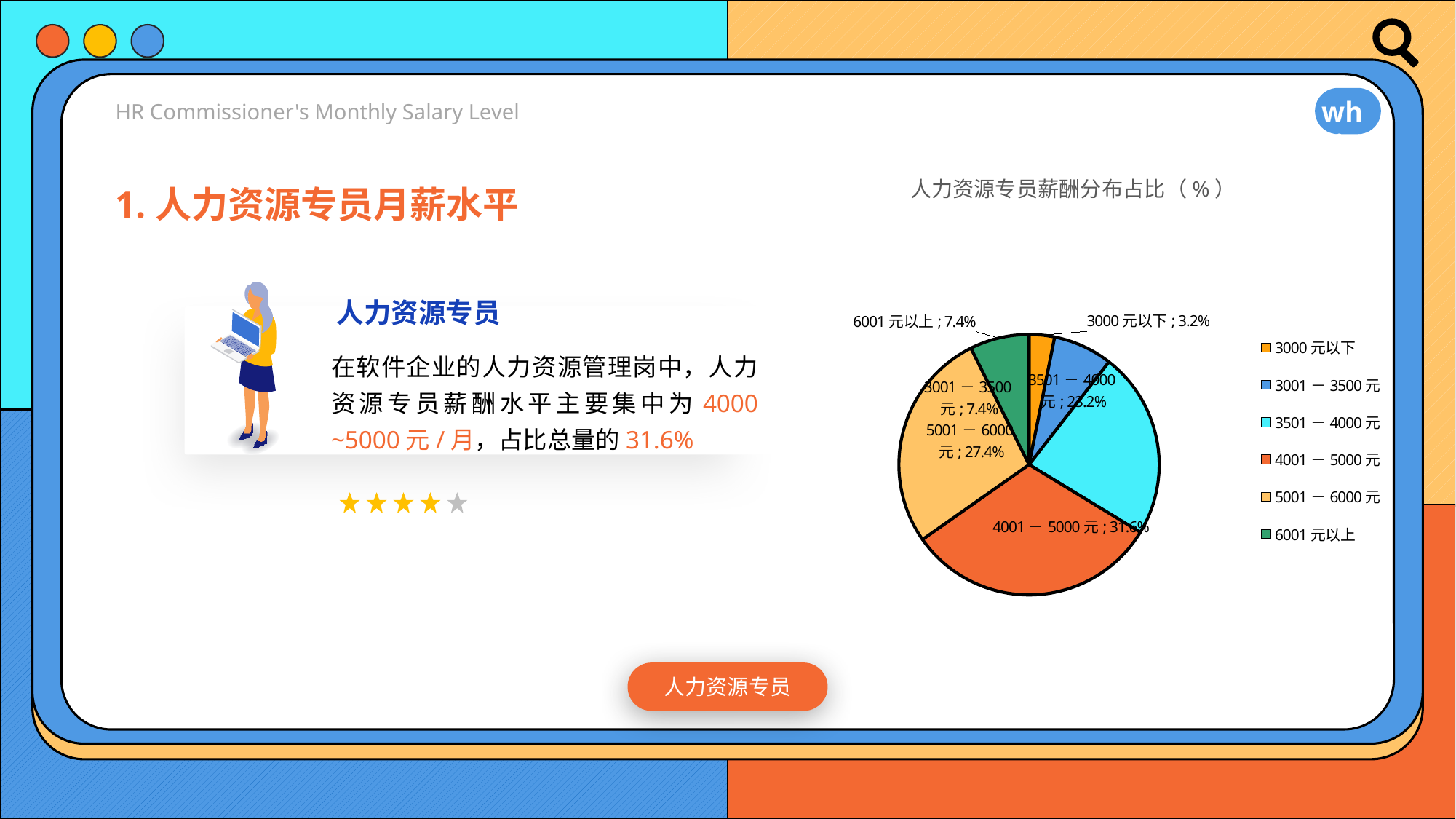
Which salary range has the smallest share of the pie? 3000 元以下 What is the value shown for 3000 元以下? 3.2% What is the value shown for 5001－6000 元? 27.4% Which salary range has the largest share of the pie? 4001－5000 元 How many slices does the pie chart have? 6 Which is larger, the share for 3501－4000 元 or the share for 5001－6000 元? 5001－6000 元 What kind of chart is shown on the slide? Pie chart What is the title of the pie chart? 人力资源专员薪酬分布占比（%） What is the value shown for 6001 元以上? 7.4% What is the difference between the shares for 4001－5000 元 and 5001－6000 元? 4.2 percentage points What share of the pie does the 4001－5000 元 slice represent? 31.6% What is the value shown for 3501－4000 元? 23.2%